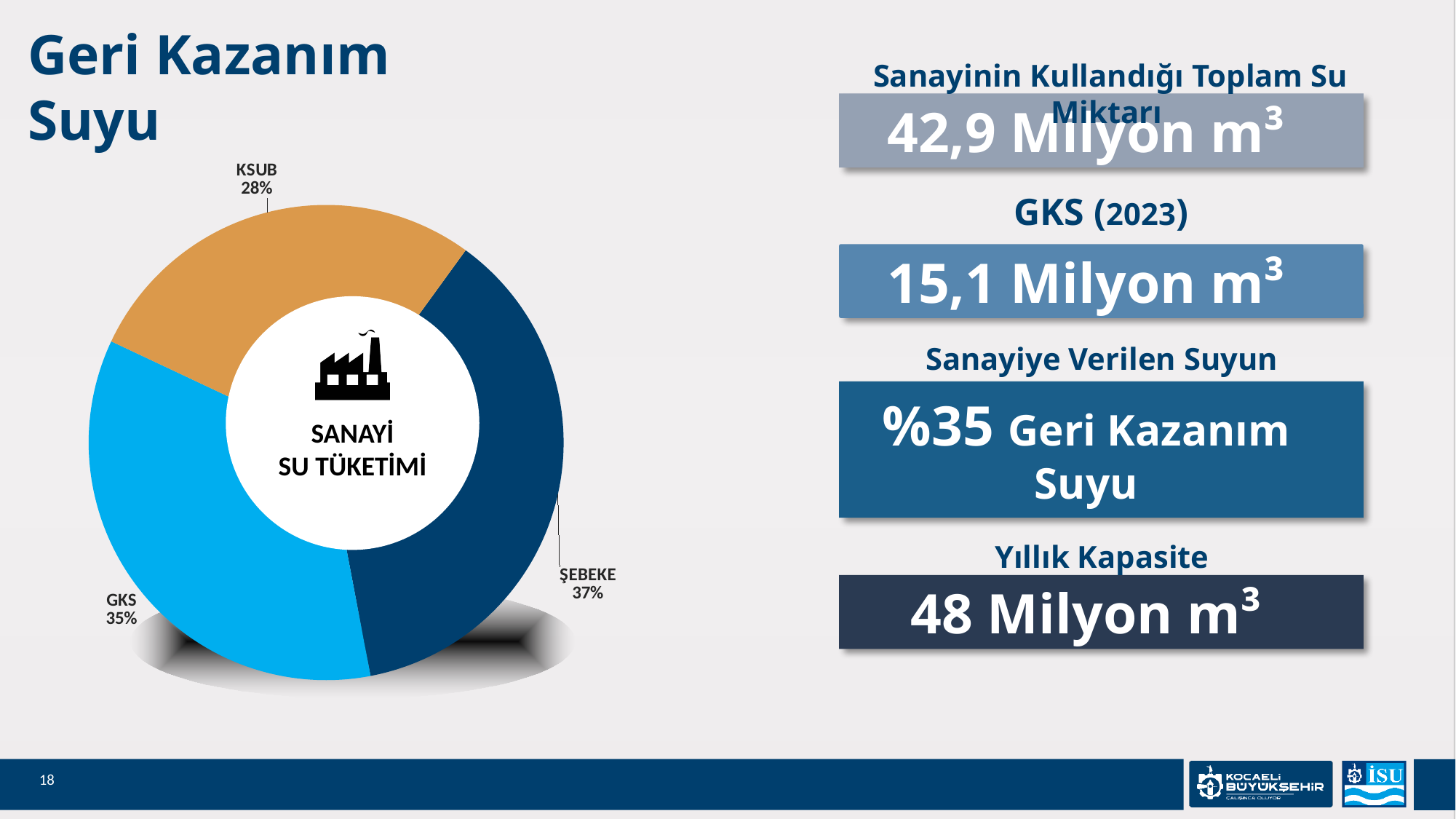
How many slices does the pie chart have? 3 Which slice of the pie chart is the smallest? KSUB What is the difference in percentage points between the GKS and KSUB slices? 7 Which slice of the pie chart is the largest? ŞEBEKE Which is larger, the GKS slice or the KSUB slice? GKS What colour is the KSUB slice of the pie chart? Orange What share of the pie chart does ŞEBEKE have? 37% What kind of chart is shown on the slide? Pie chart (doughnut) What is the difference in percentage points between the ŞEBEKE and KSUB slices? 9 What share of the pie chart does KSUB have? 28% What share of the pie chart does GKS have? 35% What text is written in the centre of the doughnut chart? SANAYİ SU TÜKETİMİ